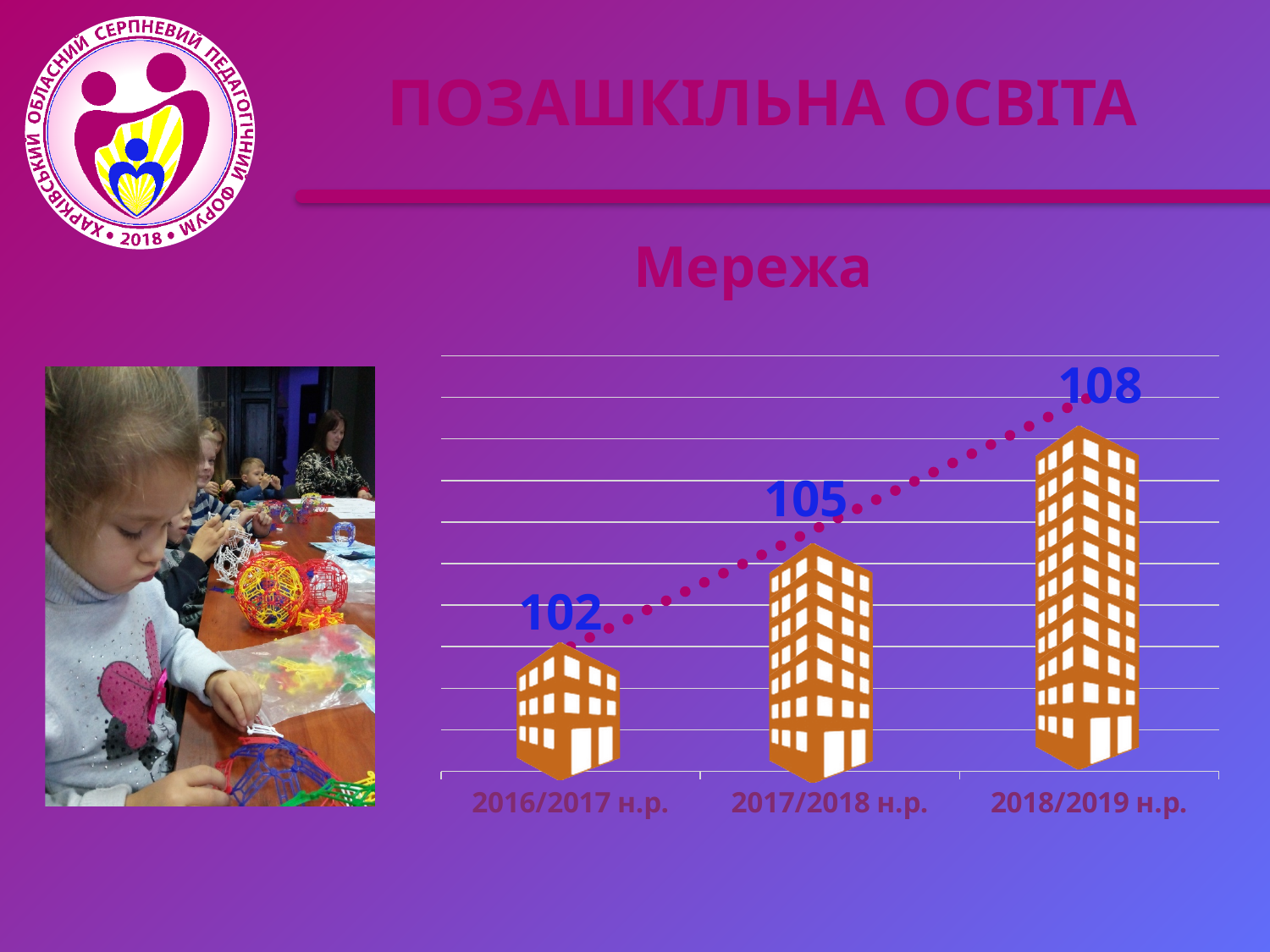
Which is larger, the value for 2017/2018 н.р. or the value for 2018/2019 н.р.? 2018/2019 н.р. What kind of chart is shown on the slide? line chart How many school years are shown on the x axis of the chart? 3 What is the difference between the values for 2018/2019 н.р. and 2016/2017 н.р.? 6 What is the value for 2018/2019 н.р.? 108 What is the title of the chart? Мережа Which school year has the lowest value? 2016/2017 н.р. What is the value for 2016/2017 н.р.? 102 Which school year has the highest value? 2018/2019 н.р. What is the value for 2017/2018 н.р.? 105 What is the difference between the values for 2017/2018 н.р. and 2016/2017 н.р.? 3 Do the values rise or fall from 2016/2017 н.р. to 2018/2019 н.р.? rise